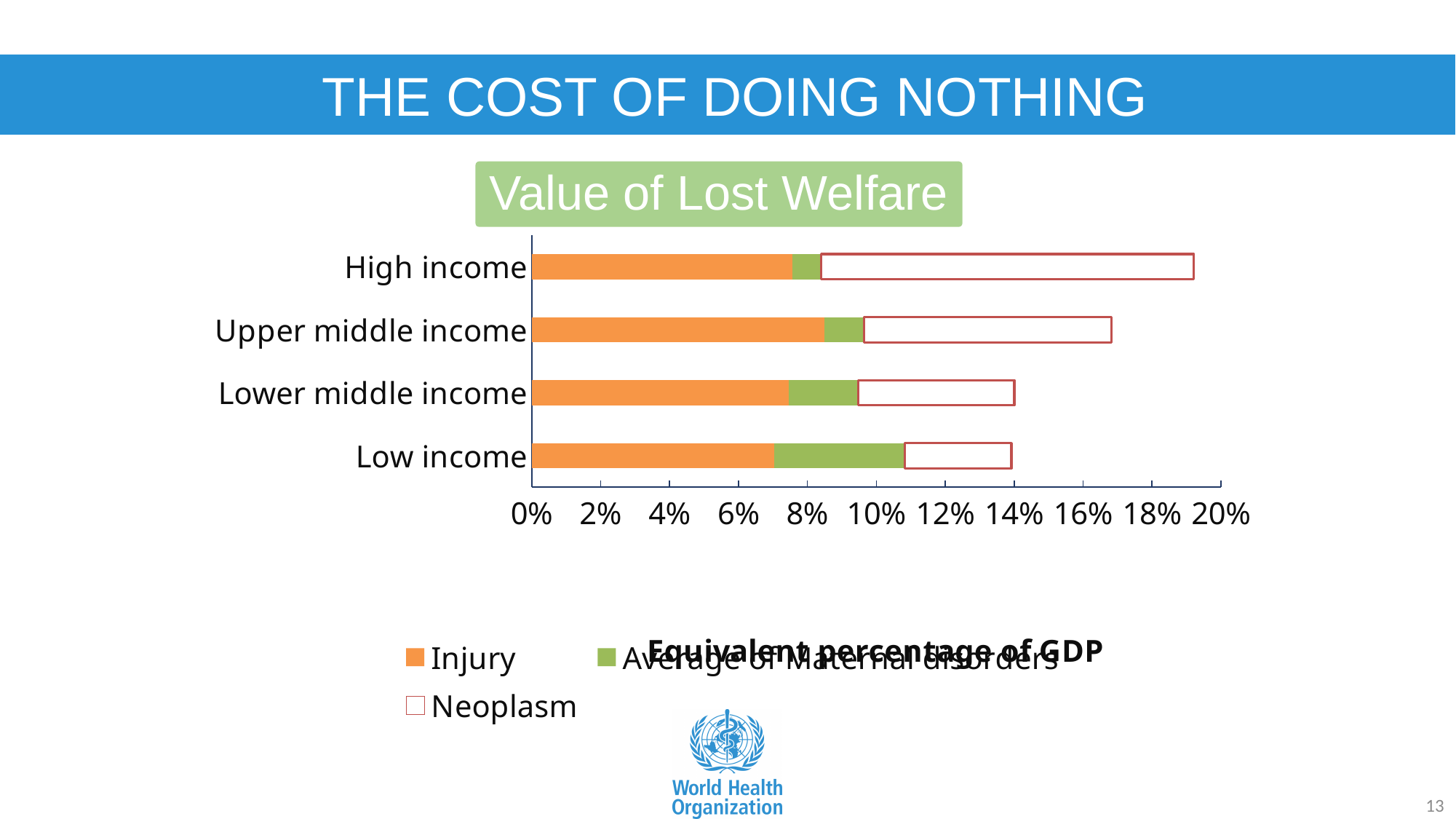
How many series does the chart legend list? 3 Is the Injury value for Upper middle income greater or less than 8%? greater Is the total bar for Upper middle income greater or less than 16%? greater Which income category has the longest total bar? High income Which is larger, the total bar for High income or for Upper middle income? High income Which series is shown in orange in the legend? Injury Which income category has the largest Average of Maternal disorders segment? Low income Is the Injury value for Low income greater or less than 8%? less How many income categories are plotted on the chart? 4 What kind of chart is shown under the title 'Value of Lost Welfare'? Stacked bar chart